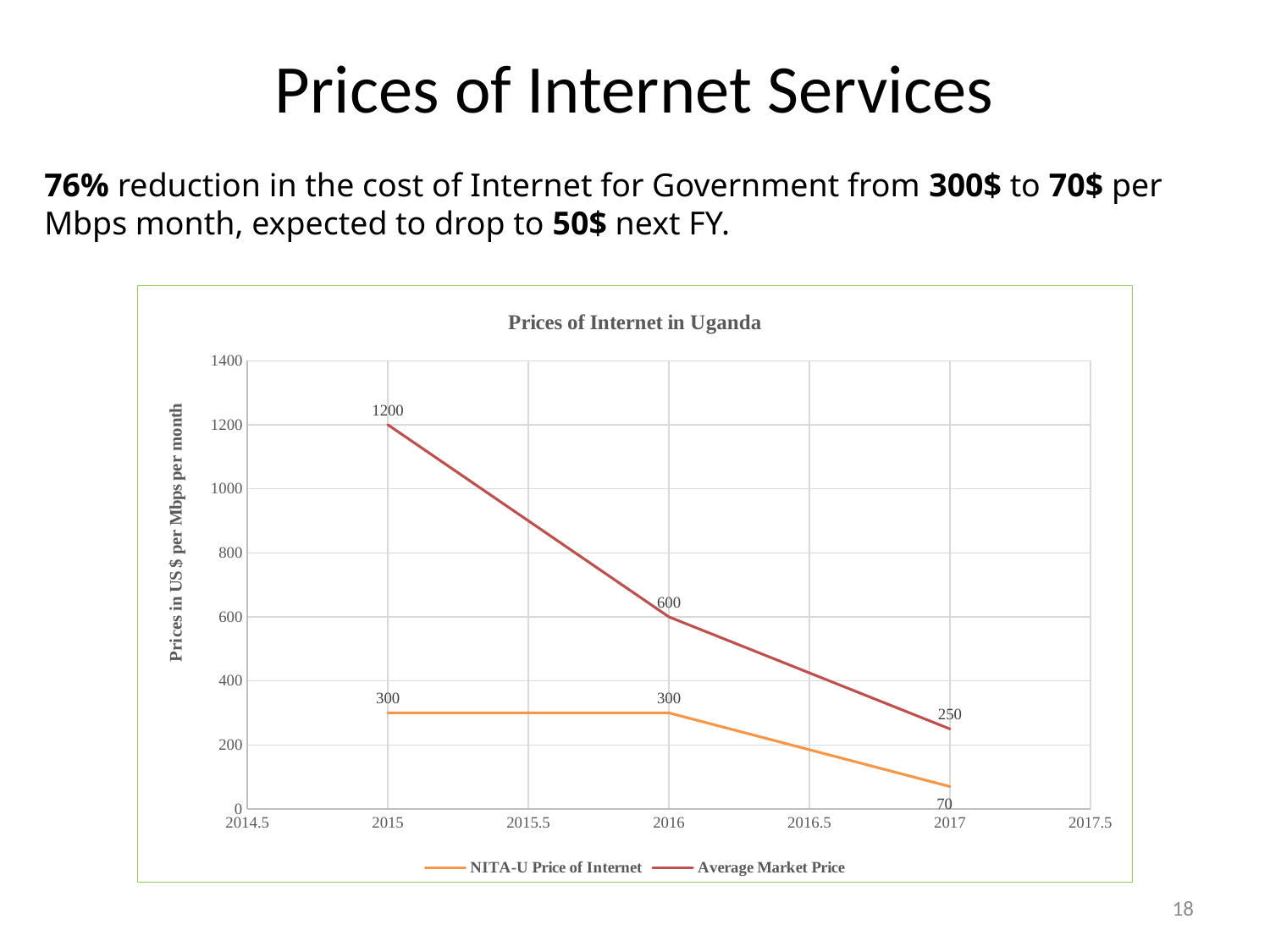
What kind of chart is shown? Line chart What is the NITA-U Price of Internet in 2017? 70 What is the Average Market Price in 2017? 250 Does the Average Market Price rise or fall from 2015 to 2017? Fall How many series does the legend list? 2 What is the difference between the Average Market Price and the NITA-U Price of Internet in 2016? 300 In which year is the NITA-U Price of Internet lowest? 2017 What is the NITA-U Price of Internet in 2016? 300 What is the Average Market Price in 2015? 1200 Which is larger in 2017, the Average Market Price or the NITA-U Price of Internet? Average Market Price In which year is the Average Market Price highest? 2015 What is the title of the chart? Prices of Internet in Uganda